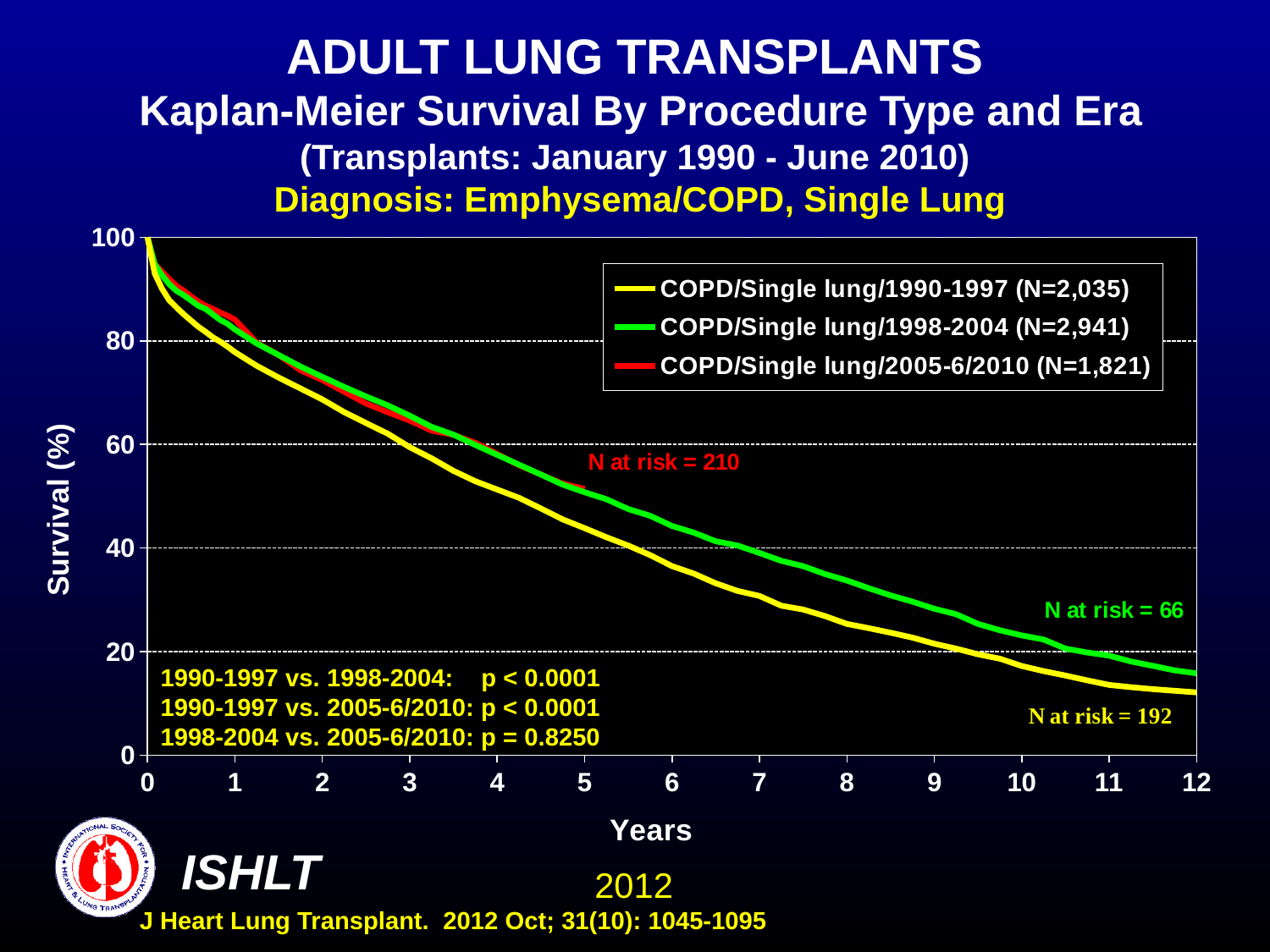
What is the p-value for 1998-2004 vs. 2005-6/2010? p = 0.8250 At 5 years, which curve shows higher survival: 1998-2004 or 1990-1997? 1998-2004 Which era's survival curve is the lowest across the years shown? COPD/Single lung/1990-1997 How many series does the legend list? 3 What is the N at risk shown for the 1990-1997 (yellow) curve? 192 Do the survival curves rise or fall as years increase? Fall What is the N for the COPD/Single lung/1990-1997 series in the legend? N=2,035 What is the N for the COPD/Single lung/1998-2004 series in the legend? N=2,941 What is the N for the COPD/Single lung/2005-6/2010 series in the legend? N=1,821 Is the survival for the 1990-1997 curve at 7 years greater or less than 40? less What kind of chart is shown on the slide? Line chart What is the N at risk shown for the 2005-6/2010 (red) curve? 210